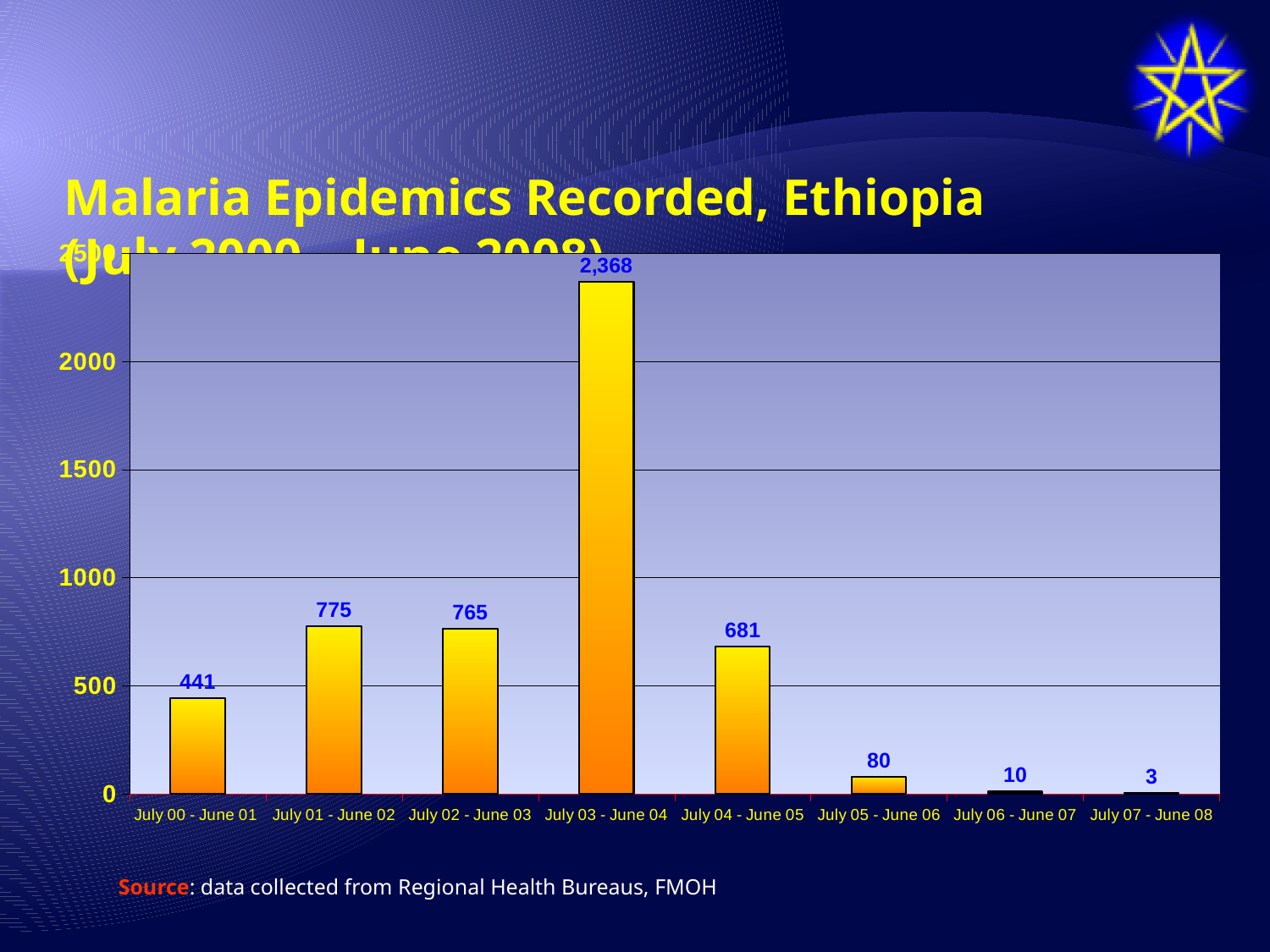
Which is larger, the value for July 04 - June 05 or the value for July 00 - June 01? July 04 - June 05 What is the value for July 00 - June 01? 441 Which period has the highest number of malaria epidemics recorded? July 03 - June 04 What kind of chart is shown on the slide? bar chart What is the value for July 05 - June 06? 80 What is the difference between the values for July 01 - June 02 and July 02 - June 03? 10 What is the difference between the values for July 03 - June 04 and July 04 - June 05? 1,687 Do the values rise or fall from July 04 - June 05 to July 07 - June 08? fall Is the value for July 01 - June 02 greater or less than 500? greater How many periods are shown on the x axis? 8 Which period has the lowest number of malaria epidemics recorded? July 07 - June 08 How many malaria epidemics were recorded in July 03 - June 04? 2,368